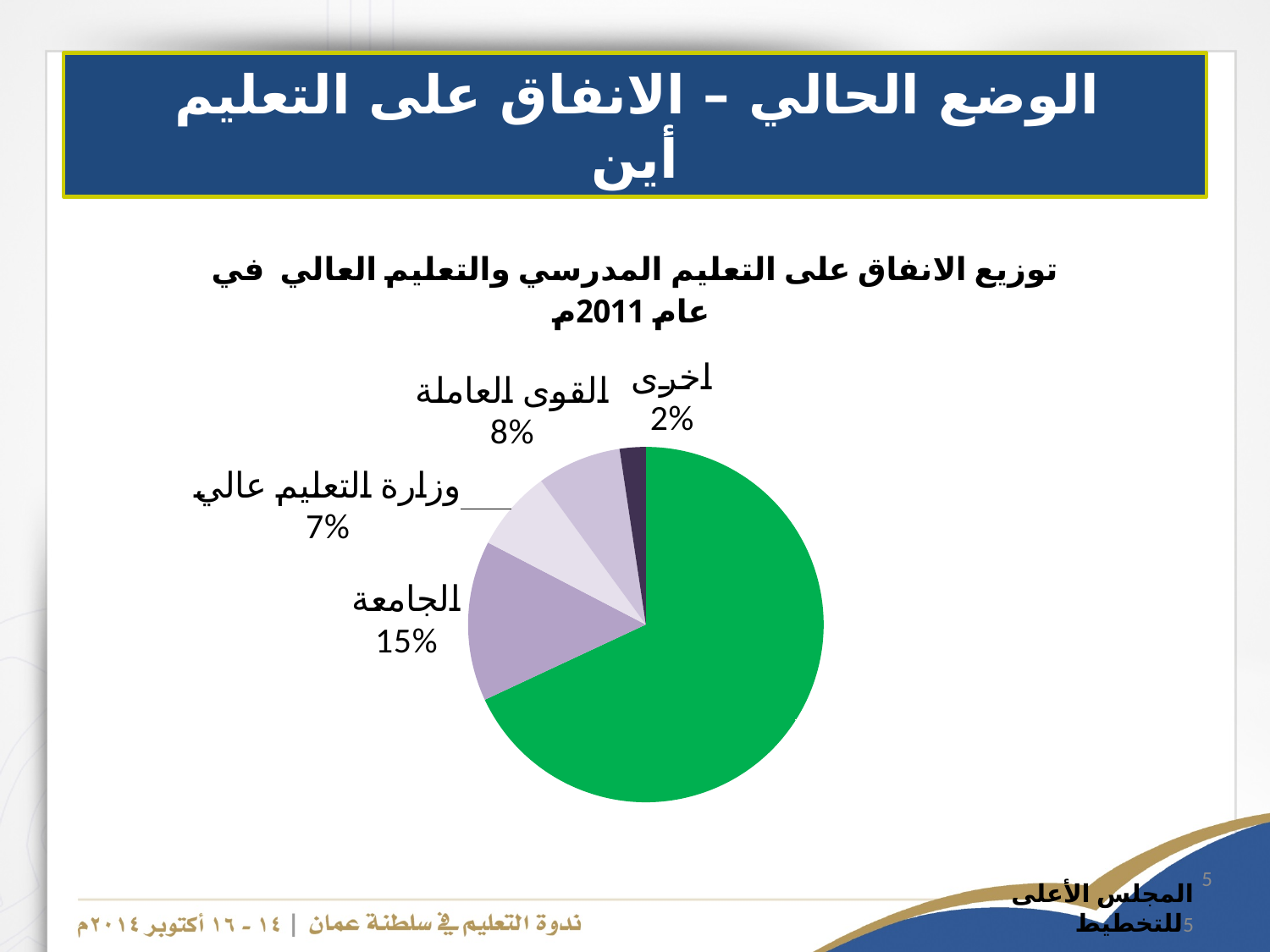
What percentage is shown for وزارة التعليم عالي in the pie chart? 7% What is the difference in percentage points between القوى العاملة and وزارة التعليم عالي in the pie chart? 1% Which year does the pie chart's title say the spending distribution refers to? 2011 What percentage is shown for أخرى in the pie chart? 2% Which is larger in the pie chart: وزارة التعليم عالي or أخرى? وزارة التعليم عالي What type of chart is shown on the slide? pie chart What percentage is shown for الجامعة in the pie chart? 15% What is the difference in percentage points between الجامعة and القوى العاملة in the pie chart? 7% How many slices does the pie chart contain? 5 What percentage is shown for القوى العاملة in the pie chart? 8% Which labeled slice of the pie chart has the smallest share? أخرى Which is larger in the pie chart: الجامعة or القوى العاملة? الجامعة